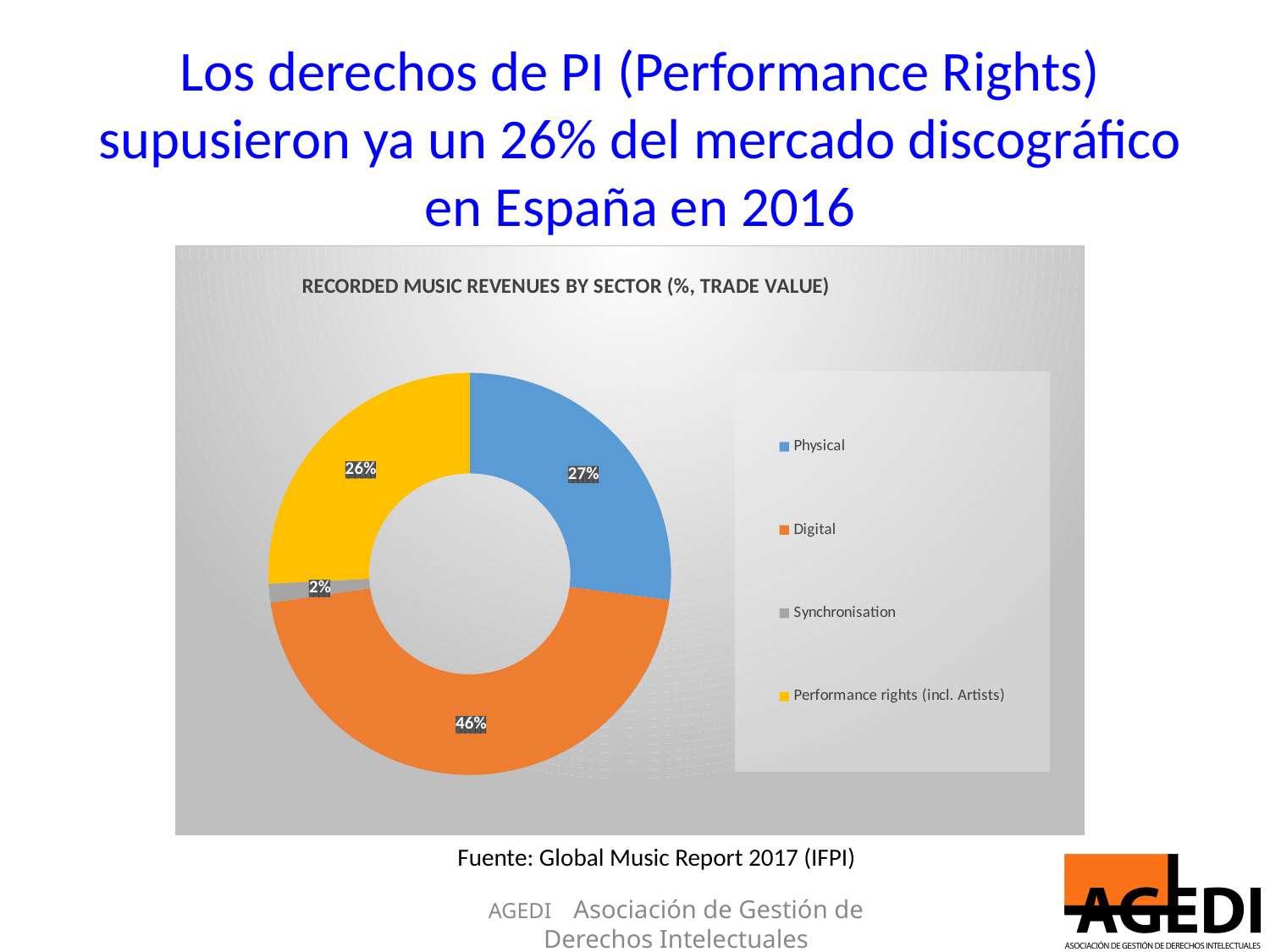
What is the title of the chart? RECORDED MUSIC REVENUES BY SECTOR (%, TRADE VALUE) Which sector has the largest share of recorded music revenues? Digital How many sectors are shown in the chart? 4 What is the difference in percentage points between the Digital and Physical shares? 19 What share of recorded music revenues does Digital account for? 46% Which sector has the smallest share of recorded music revenues? Synchronisation What share of recorded music revenues does Synchronisation account for? 2% What kind of chart is shown on the slide? Doughnut (pie) chart What colour represents Performance rights (incl. Artists) in the chart? Yellow What share of recorded music revenues do Performance rights (incl. Artists) account for? 26% What share of recorded music revenues does Physical account for? 27% Which is larger, the Physical share or the Performance rights share? Physical